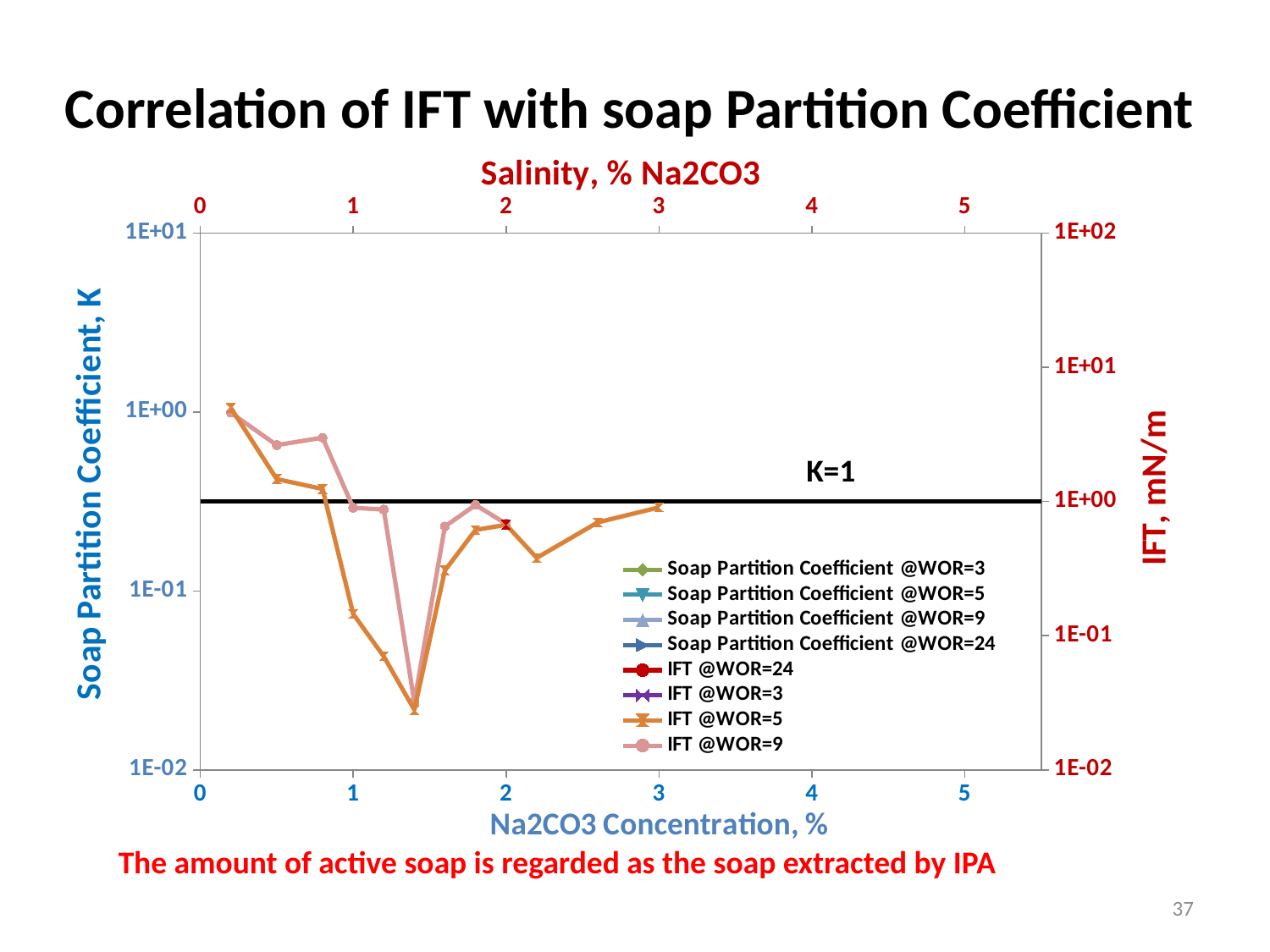
What kind of chart is shown on the slide? line chart Does the IFT @WOR=5 series rise or fall as the Na2CO3 concentration increases from 1.4% to 1.8%? rise What label is written on the horizontal black reference line in the chart? K=1 Is the IFT @WOR=5 value at a Na2CO3 concentration of 1.4% greater or less than 1E-01 mN/m? less Is the IFT @WOR=5 value at a Na2CO3 concentration of 0.2% greater or less than 1E+00 mN/m? greater At a Na2CO3 concentration of 1%, which series has the higher IFT value: IFT @WOR=5 or IFT @WOR=9? IFT @WOR=9 What is the title of the chart on the slide? Correlation of IFT with soap Partition Coefficient What is the highest tick value shown on the right-hand IFT axis? 1E+02 Is the IFT @WOR=9 value at a Na2CO3 concentration of 0.8% greater or less than 1E+00 mN/m? greater Does the IFT @WOR=5 series rise or fall as the Na2CO3 concentration increases from 0.2% to 1.4%? fall How many series does the legend list? 8